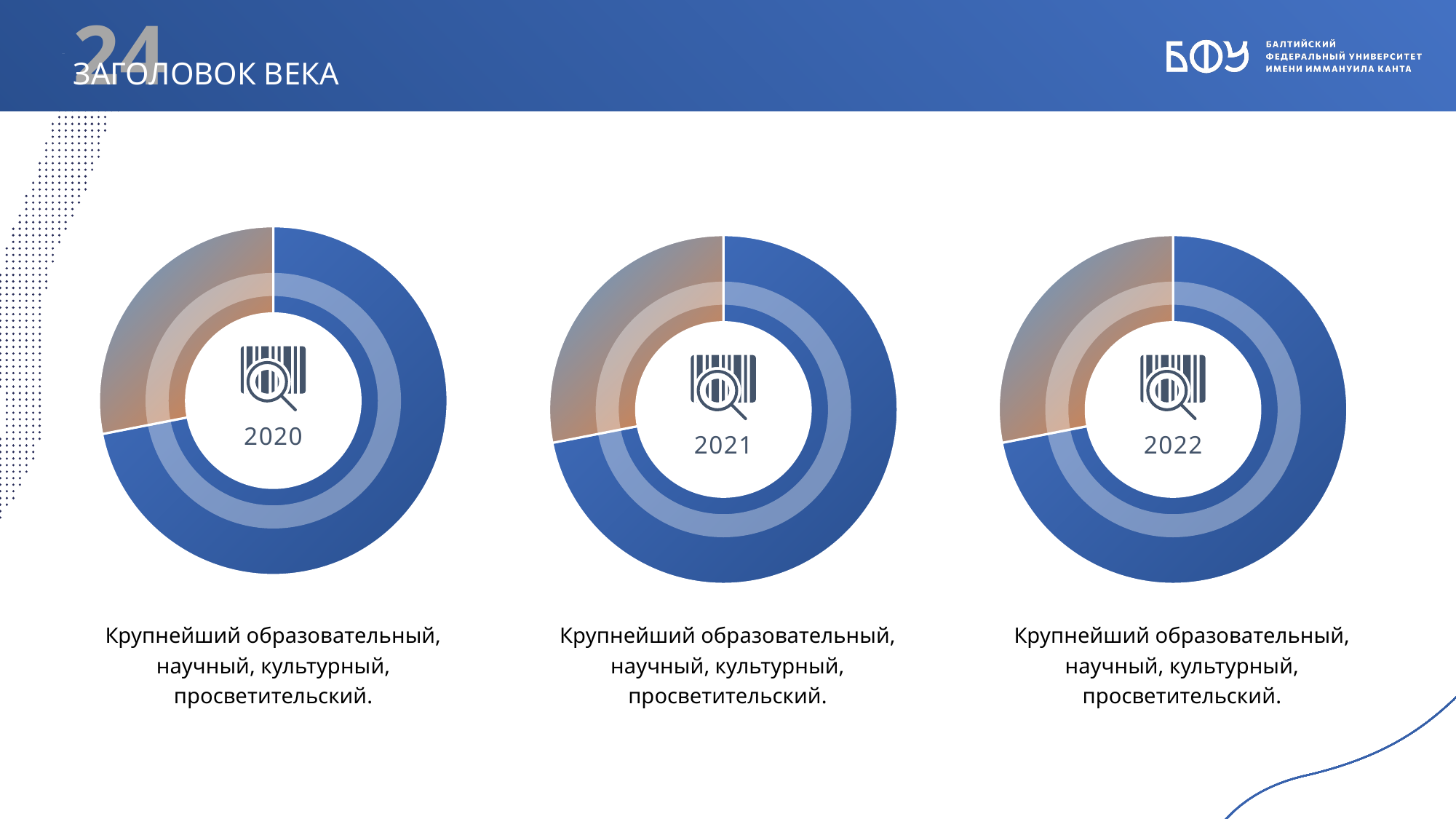
In the 2021 chart, how many slices does the ring have? 2 In the 2020 chart, how many slices does the ring have? 2 In the 2020 chart, which slice is larger, the blue one or the brown one? the blue one What year is written in the centre of the right chart? 2022 In the 2022 chart, which slice is larger, the blue one or the brown one? the blue one What year is written in the centre of the middle chart? 2021 What kind of chart is the left chart labelled 2020? donut chart How many charts are shown on the slide? 3 In the 2021 chart, which slice is smaller, the blue one or the brown one? the brown one